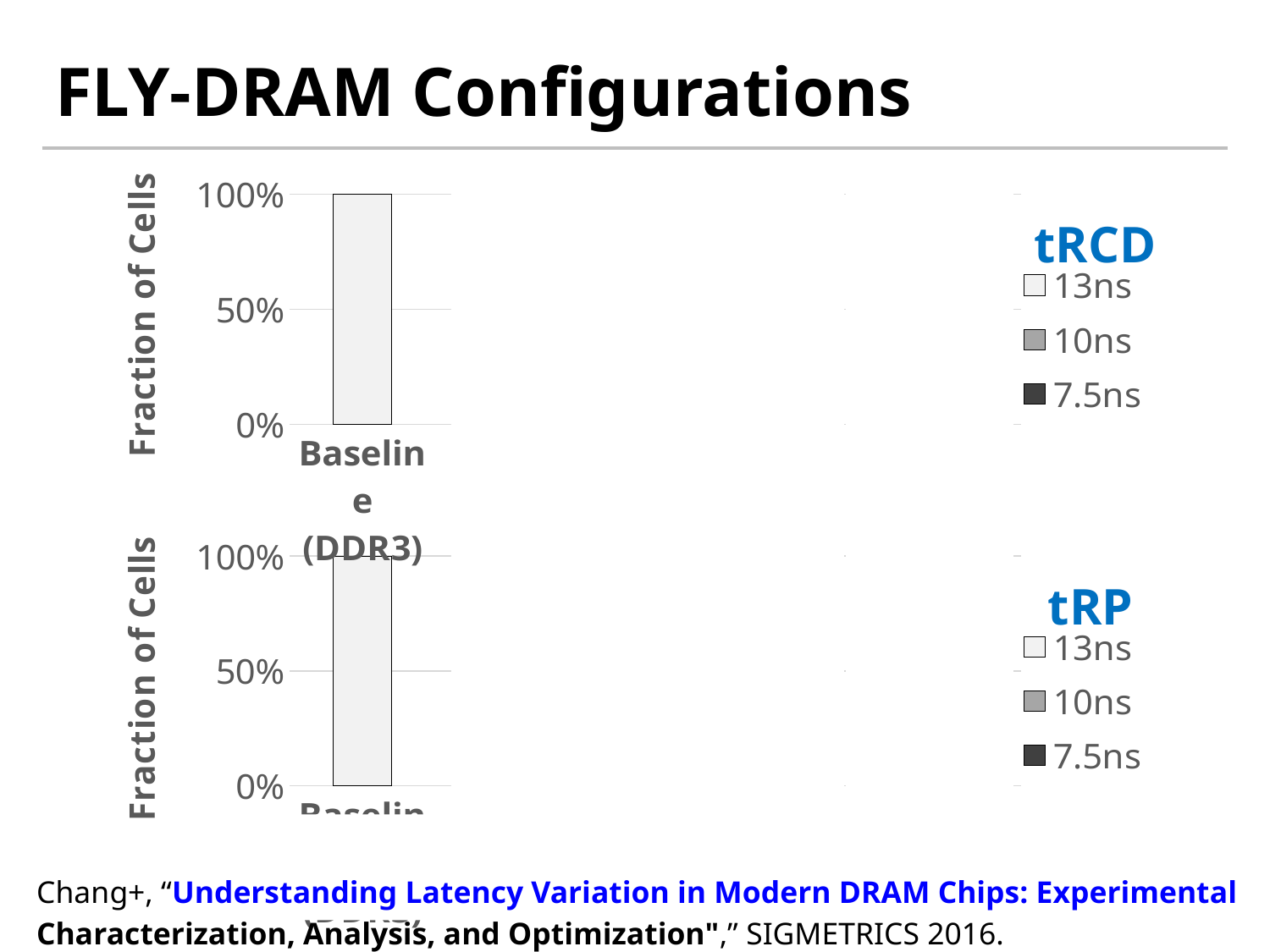
In the top chart (tRCD), what is the label of the y axis? Fraction of Cells In the top chart (tRCD), what are the three legend entries? 13ns, 10ns, 7.5ns In the bottom chart (tRP), how many series does the legend list? 3 In the top chart (tRCD), is the value of the Baseline (DDR3) bar greater or less than 50%? greater In the bottom chart (tRP), what kind of chart is shown? bar chart In the bottom chart (tRP), what value does the single visible bar reach? 100% In the top chart (tRCD), how many series does the legend list? 3 In the top chart (tRCD), how many bars are plotted? 1 In the bottom chart (tRP), is the value of the visible bar greater or less than 50%? greater In the bottom chart (tRP), how many bars are plotted? 1 In the top chart (tRCD), what kind of chart is shown? bar chart In the top chart (tRCD), what is the value of the Baseline (DDR3) bar? 100%